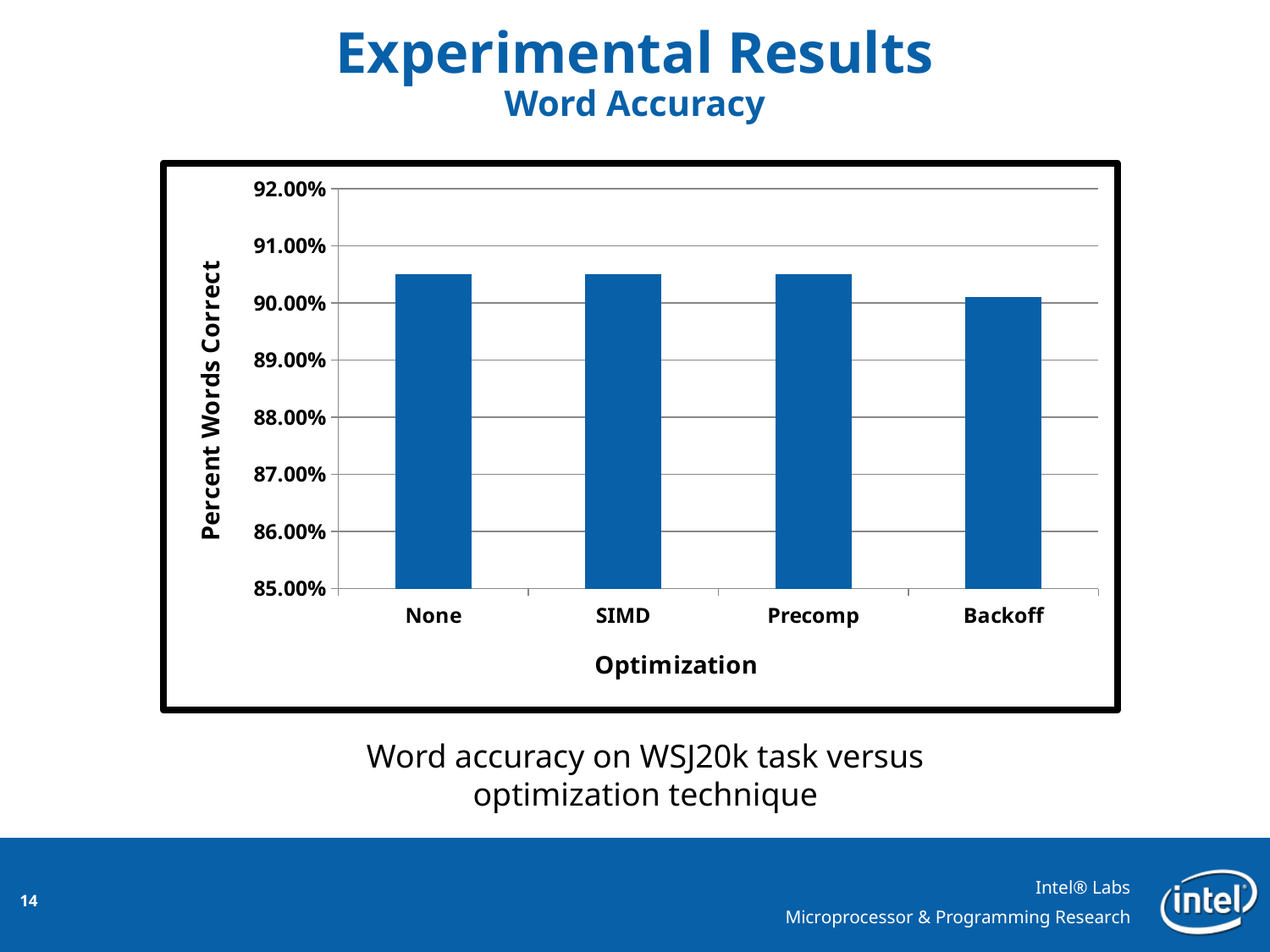
Which has a higher percent words correct, Backoff or Precomp? Precomp What is the label of the x axis? Optimization What is the label of the y axis? Percent Words Correct Is the value for Backoff greater or less than 91.00%? less Is the value for SIMD greater or less than 91.00%? less What kind of chart is shown on the slide? bar chart Is the value for None greater or less than 90.00%? greater Which optimization has the lowest percent words correct? Backoff How many optimization categories are plotted on the x axis? 4 Which has a higher percent words correct, None or Backoff? None